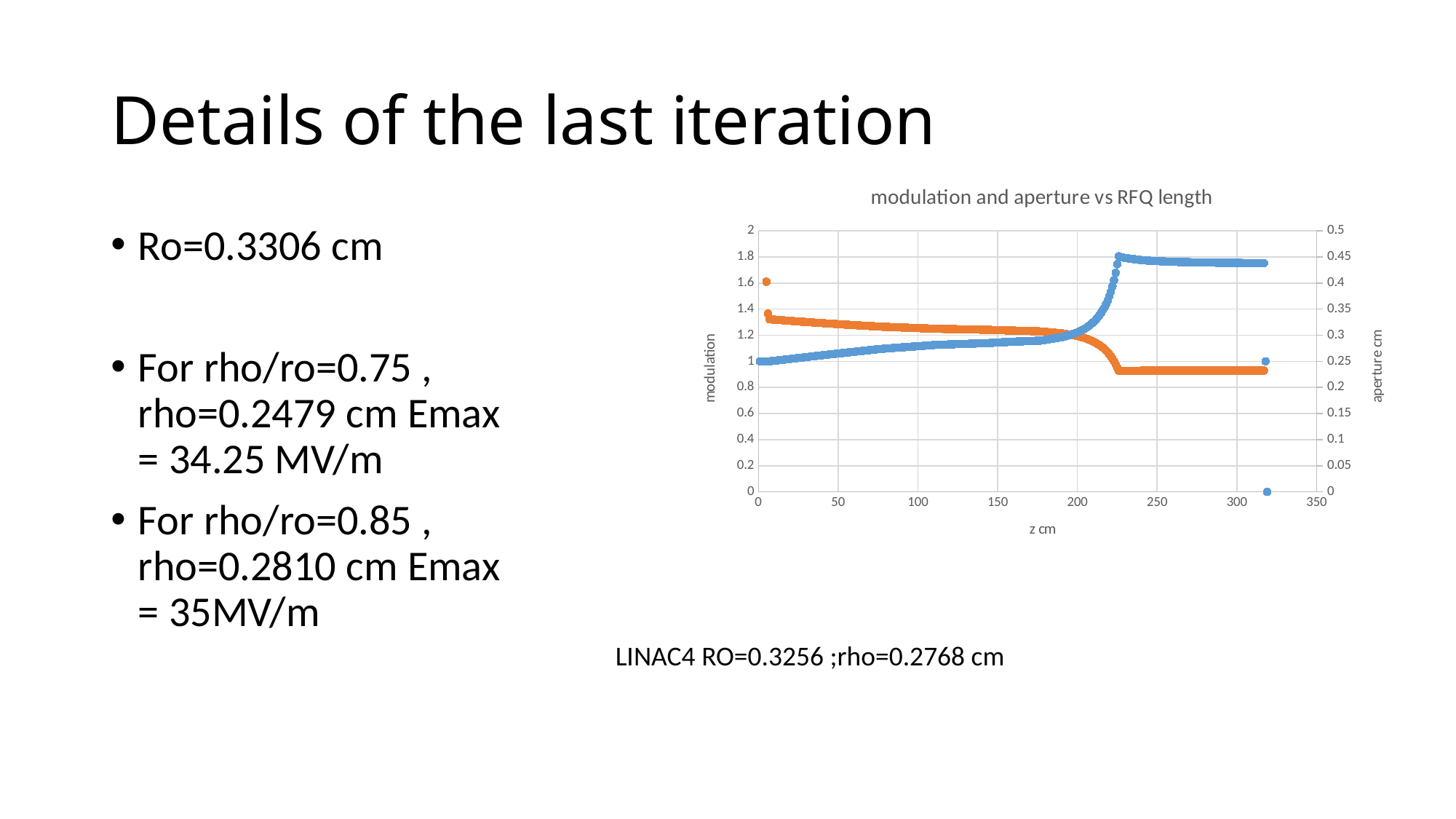
Does the orange (aperture) series rise or fall as z increases along the x axis? fall Which series has the higher value on its own axis scale at z = 300 cm: the blue modulation series (left axis) or the orange aperture series (right axis)? blue modulation series Does the blue (modulation) series rise or fall as z increases along the x axis? rise What is the title of the chart? modulation and aperture vs RFQ length What is the highest tick value shown on the x axis of the chart? 350 Is the aperture value (orange series) at z = 300 cm greater or less than 0.25 on the right axis? less Is the aperture value (orange series) at z = 100 cm greater or less than 0.25 on the right axis? greater What kind of chart is shown on the slide? scatter chart What is the label of the x axis of the chart? z cm Is the modulation value (blue series) at z = 250 cm greater or less than 1.6 on the left axis? greater